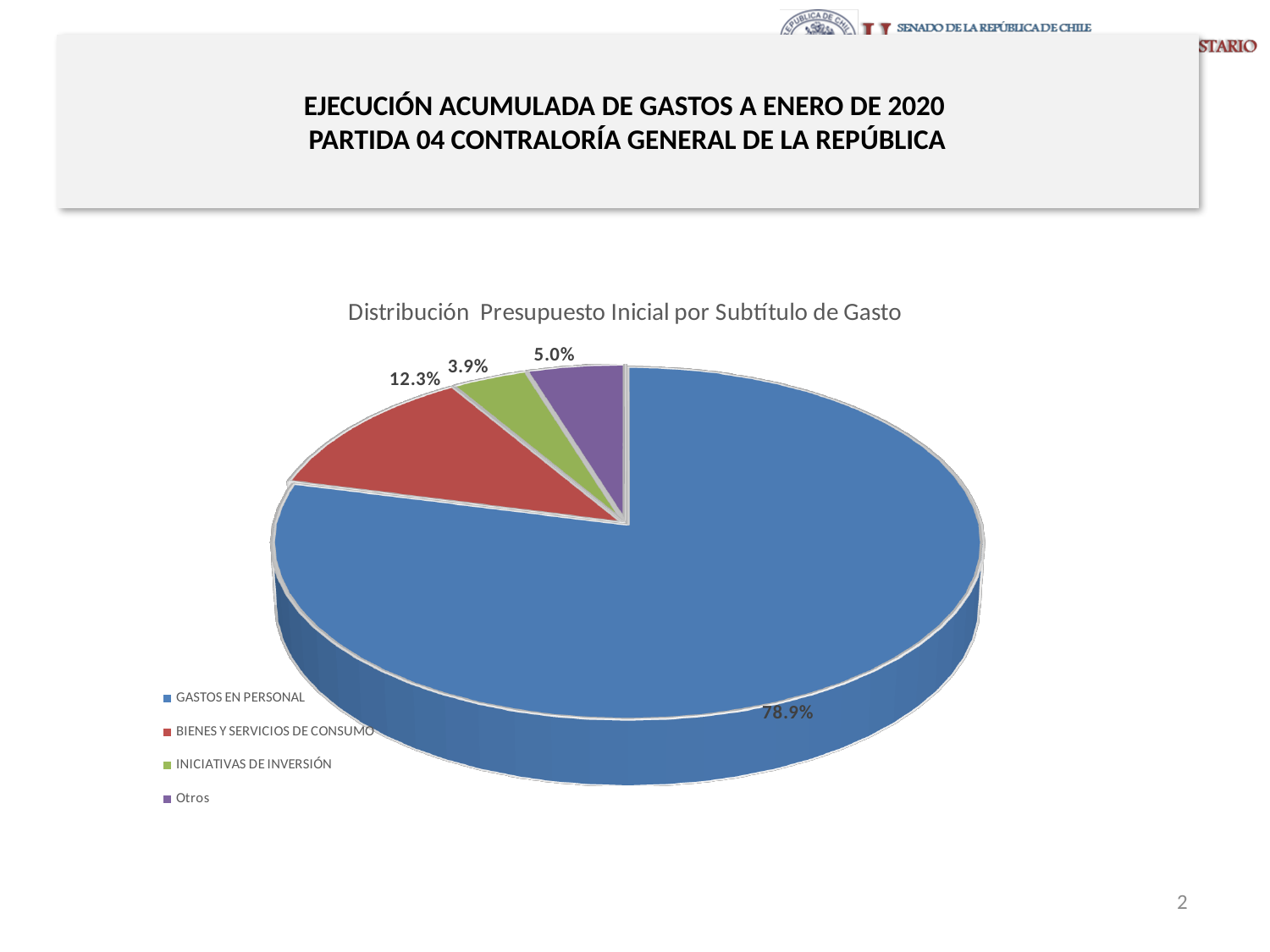
What share of the pie does GASTOS EN PERSONAL represent? 78.9% What share of the pie does Otros represent? 5.0% What is the difference between the shares of GASTOS EN PERSONAL and BIENES Y SERVICIOS DE CONSUMO? 66.6% Which is larger, the share for Otros or the share for INICIATIVAS DE INVERSIÓN? Otros What is the chart's title? Distribución Presupuesto Inicial por Subtítulo de Gasto What share of the pie does BIENES Y SERVICIOS DE CONSUMO represent? 12.3% Which category has the largest slice of the pie? GASTOS EN PERSONAL What type of chart is shown on the slide? Pie chart What colour is the slice for BIENES Y SERVICIOS DE CONSUMO? Red Which category has the smallest slice of the pie? INICIATIVAS DE INVERSIÓN How many categories does the legend list? 4